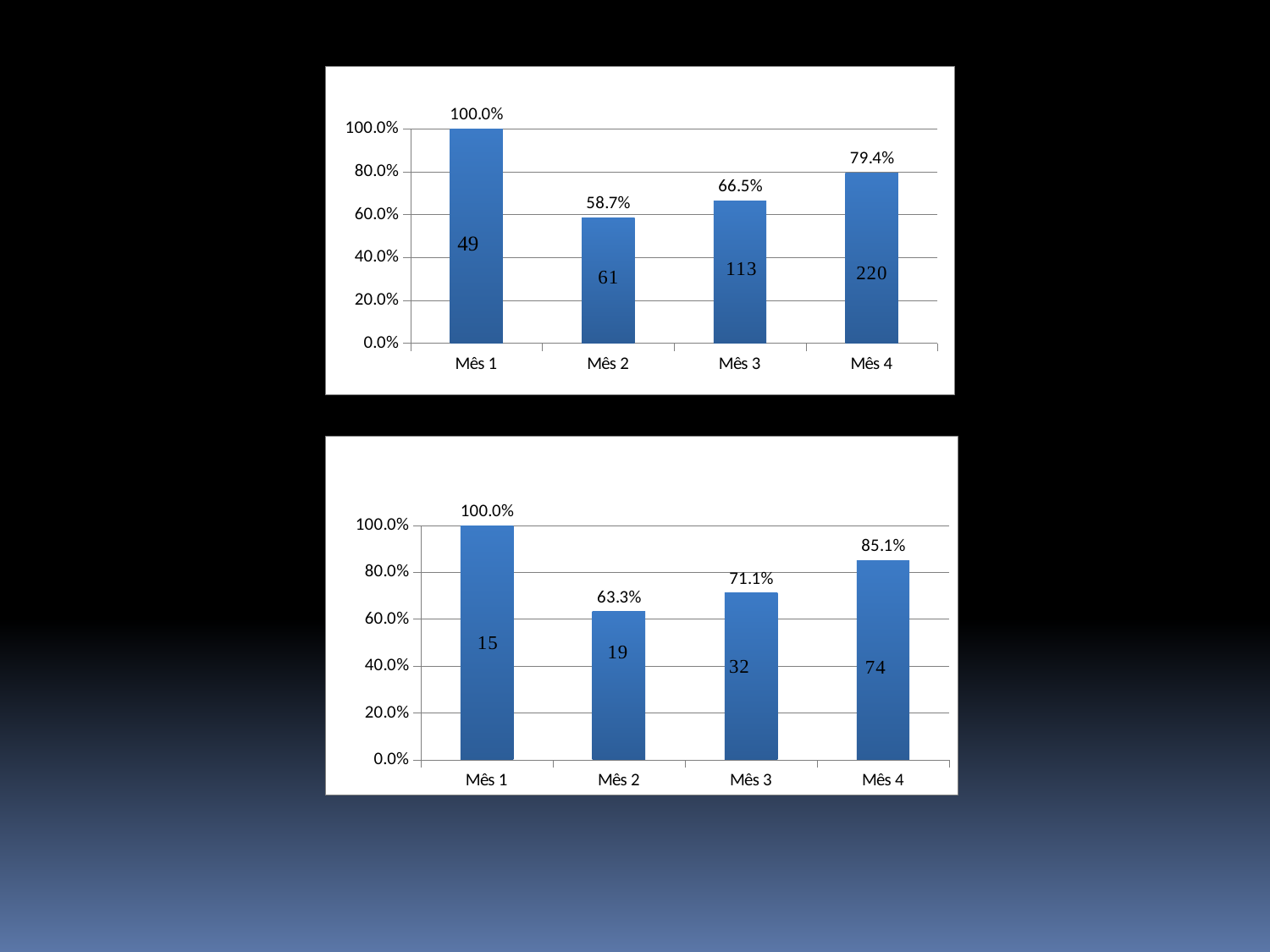
What type of chart is the bottom chart? bar chart In the top chart, what is the difference in percentage points between Mês 4 and Mês 2? 20.7 In the bottom chart, which month has the highest percentage? Mês 1 In the bottom chart, what is the percentage value for Mês 2? 63.3% In the top chart, what is the percentage value for Mês 3? 66.5% In the top chart, what number is printed inside the bar for Mês 4? 220 In the bottom chart, what number is printed inside the bar for Mês 3? 32 In the bottom chart, what is the difference in percentage points between Mês 1 and Mês 4? 14.9 In the bottom chart, is the percentage for Mês 4 larger or smaller than that for Mês 3? larger In the top chart, do the percentages rise or fall from Mês 2 to Mês 4? rise In the top chart, how many months are shown on the x axis? 4 In the top chart, which month has the lowest percentage? Mês 2